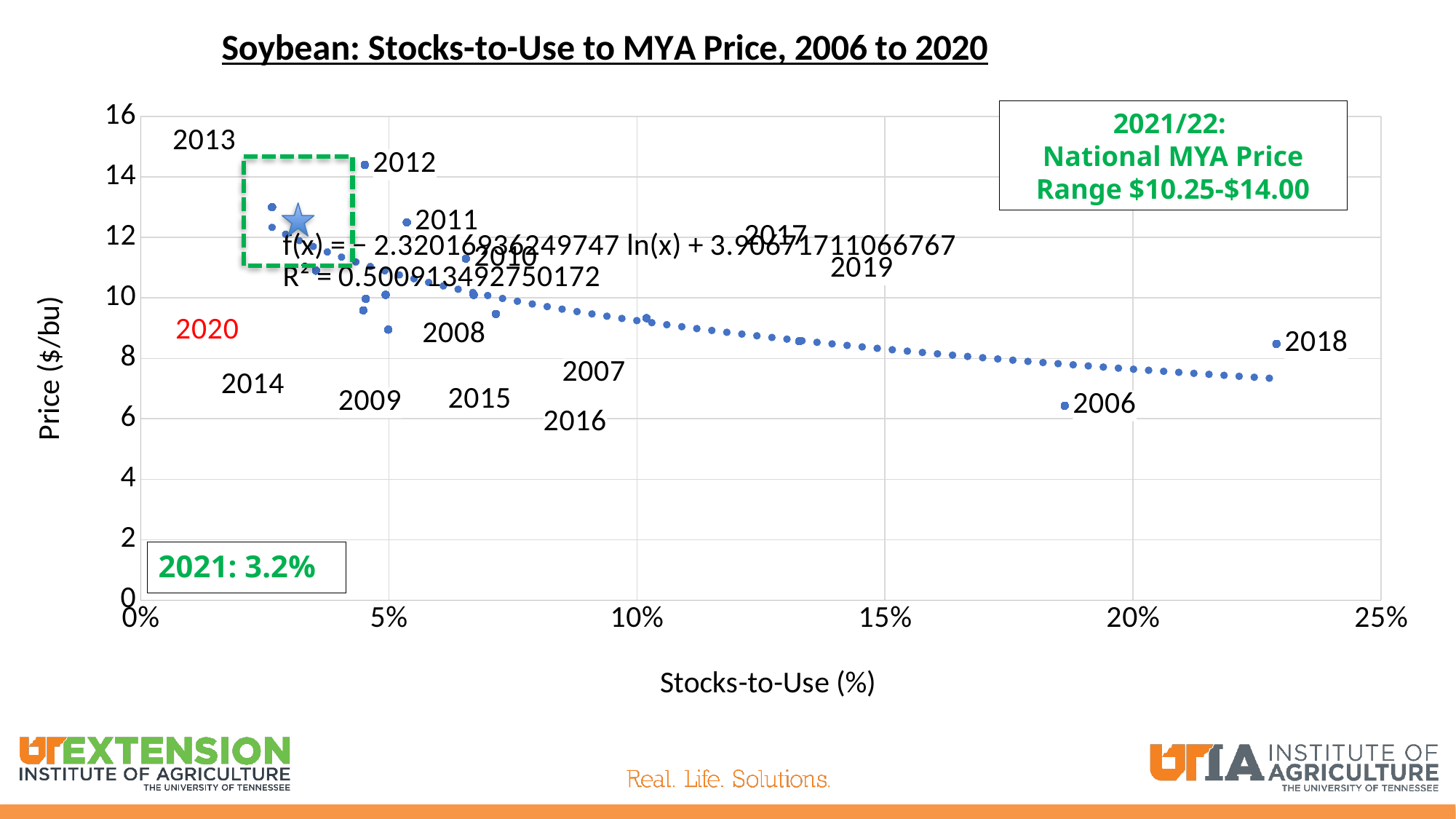
Which year has the highest stocks-to-use value? 2018 Which year has a higher stocks-to-use value, 2006 or 2018? 2018 Is the stocks-to-use value for 2018 greater or less than 20%? greater Is the price for 2006 greater or less than 8 $/bu? less How many years are plotted as labeled points on the chart? 15 As stocks-to-use increases along the x axis, does the fitted trendline rise or fall? Fall What kind of chart is shown on the slide? Scatter chart Which year has the lowest price on the chart? 2006 What is the label of the vertical axis? Price ($/bu) What is the title of the chart? Soybean: Stocks-to-Use to MYA Price, 2006 to 2020 Which year has the highest price on the chart? 2012 Is the price for 2012 greater or less than 12 $/bu? greater